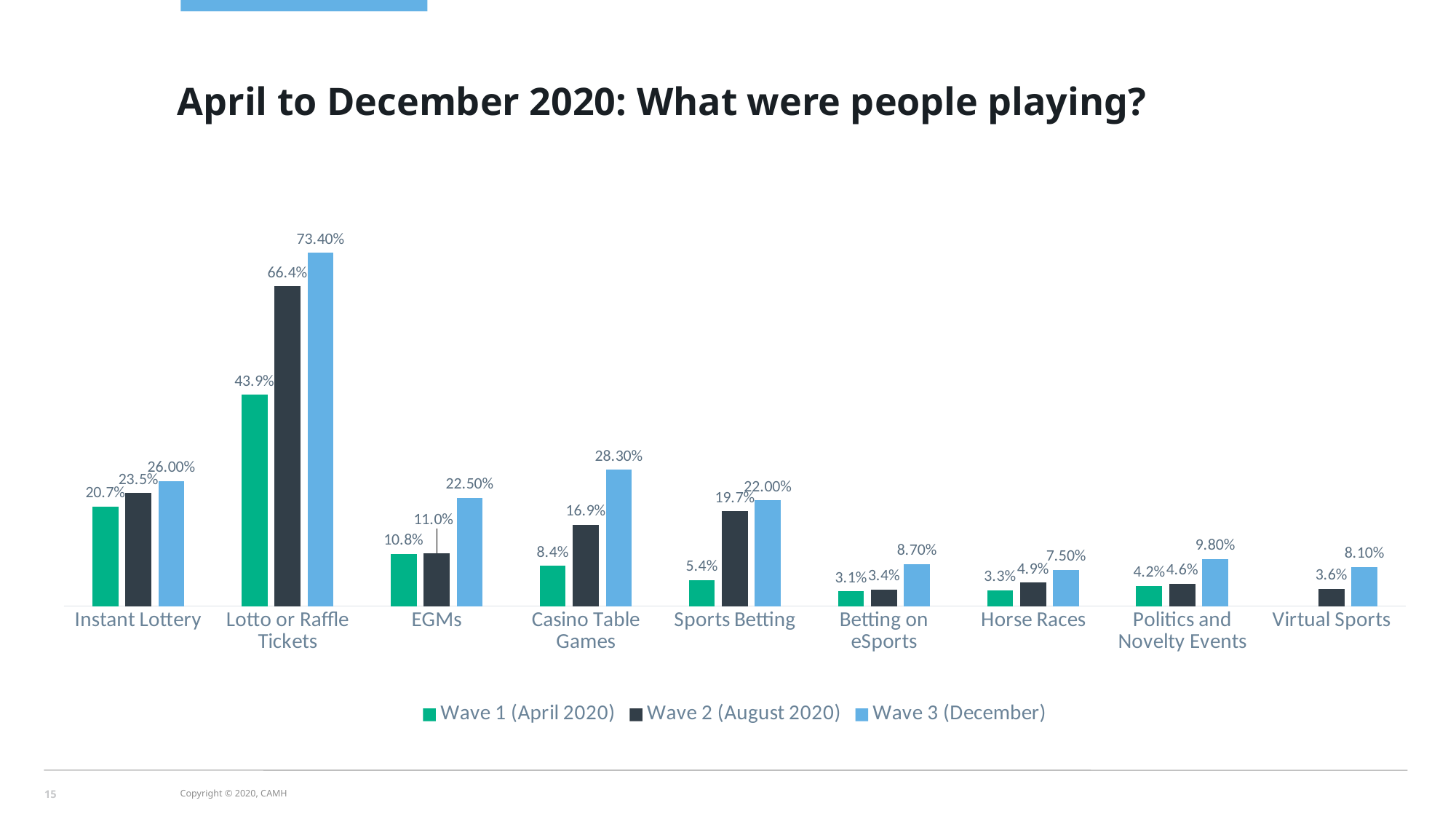
What kind of chart is shown on the slide? Bar chart Which category has the lowest Wave 1 (April 2020) value among those with a Wave 1 bar? Betting on eSports Do the values for Instant Lottery rise or fall from Wave 1 to Wave 3? Rise What is the difference between the Wave 3 (December) and Wave 1 (April 2020) values for Casino Table Games? 19.9% Which category has the highest Wave 2 (August 2020) value? Lotto or Raffle Tickets What is the difference between the Wave 2 (August 2020) and Wave 1 (April 2020) values for Lotto or Raffle Tickets? 22.5% Which is larger: the Wave 2 (August 2020) value for Sports Betting or for Casino Table Games? Sports Betting How many series does the legend list? 3 What is the Wave 3 (December) value for Lotto or Raffle Tickets? 73.40% How many categories are shown on the x axis? 9 What is the Wave 2 (August 2020) value for Casino Table Games? 16.9% What is the Wave 1 (April 2020) value for Sports Betting? 5.4%